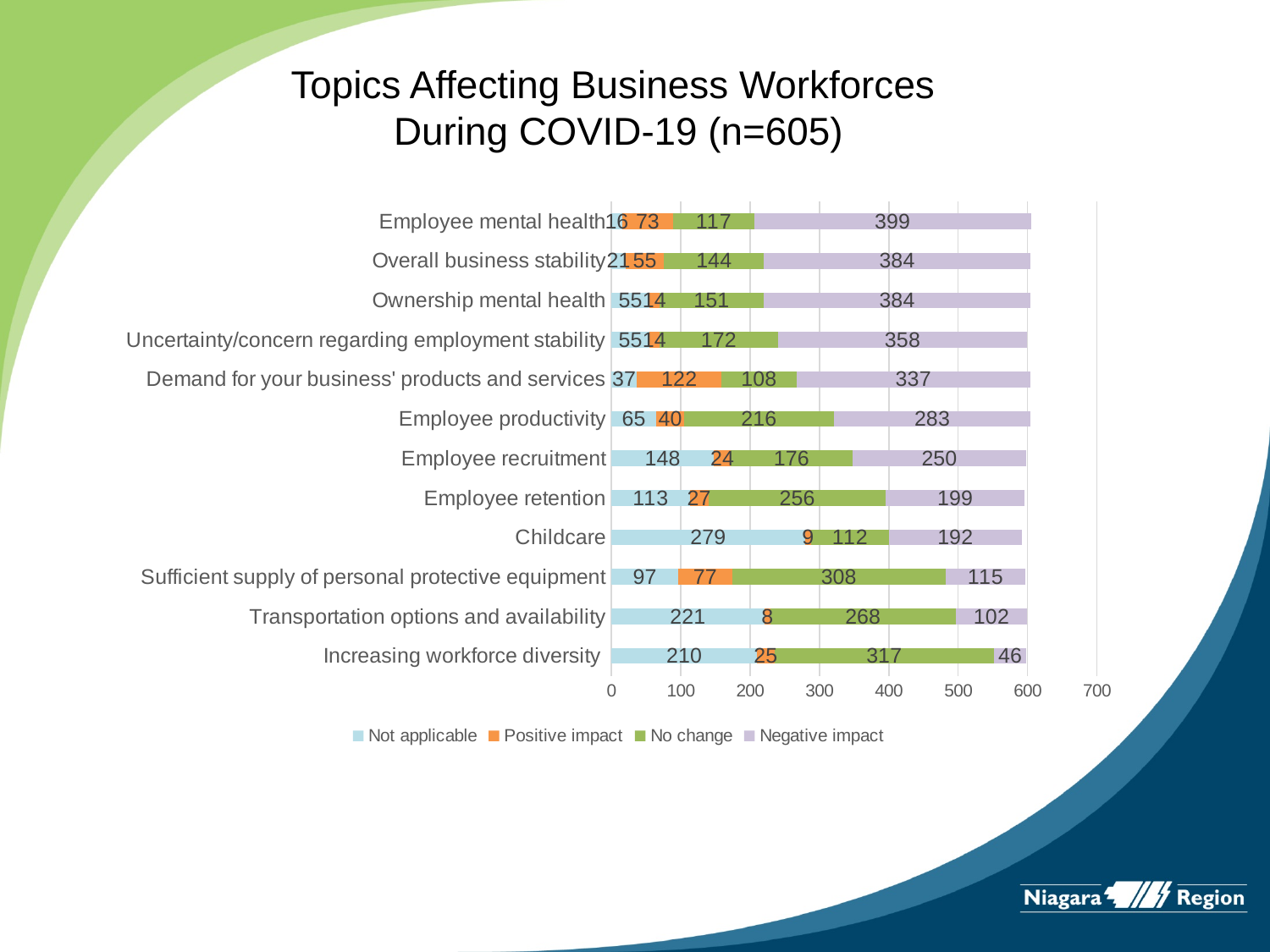
How many topics are listed on the chart? 12 Which topic has the highest Negative impact value? Employee mental health What is the total of the stacked bar for Increasing workforce diversity? 598 What is the Negative impact value for Employee mental health? 399 What is the difference between the Negative impact values for Employee mental health and Overall business stability? 15 Which topic has the highest Not applicable value? Childcare What kind of chart is shown on the slide? Stacked bar chart How many series does the legend list? 4 Which has a larger No change value, Employee retention or Employee recruitment? Employee retention What is the Positive impact value for Demand for your business' products and services? 122 What is the No change value for Sufficient supply of personal protective equipment? 308 Which topic has the lowest Negative impact value? Increasing workforce diversity